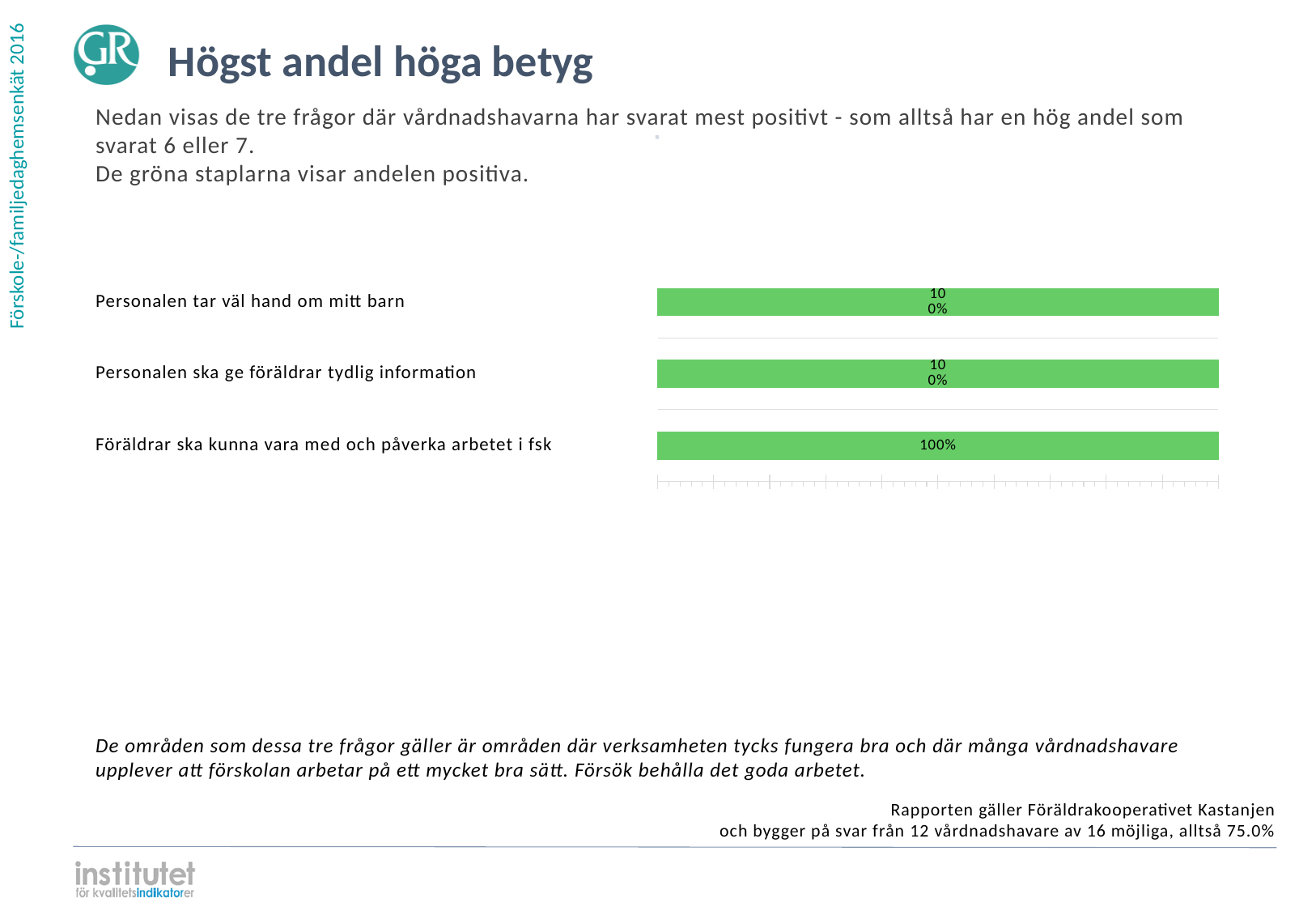
What colour are the bars in the chart? Green What is the value for "Personalen ska ge föräldrar tydlig information"? 100% Do all three bars in the chart show the same value? Yes, 100% What kind of chart is shown on the slide? Bar chart What is the value for "Personalen tar väl hand om mitt barn"? 100% What is the value for "Föräldrar ska kunna vara med och påverka arbetet i fsk"? 100% Is the value for "Föräldrar ska kunna vara med och påverka arbetet i fsk" greater or less than 90%? greater Is the value for "Personalen tar väl hand om mitt barn" greater or less than 50%? greater What is the difference between the values for "Personalen tar väl hand om mitt barn" and "Personalen ska ge föräldrar tydlig information"? 0% What is the title of the slide containing the chart? Högst andel höga betyg How many categories (questions) are shown in the chart? 3